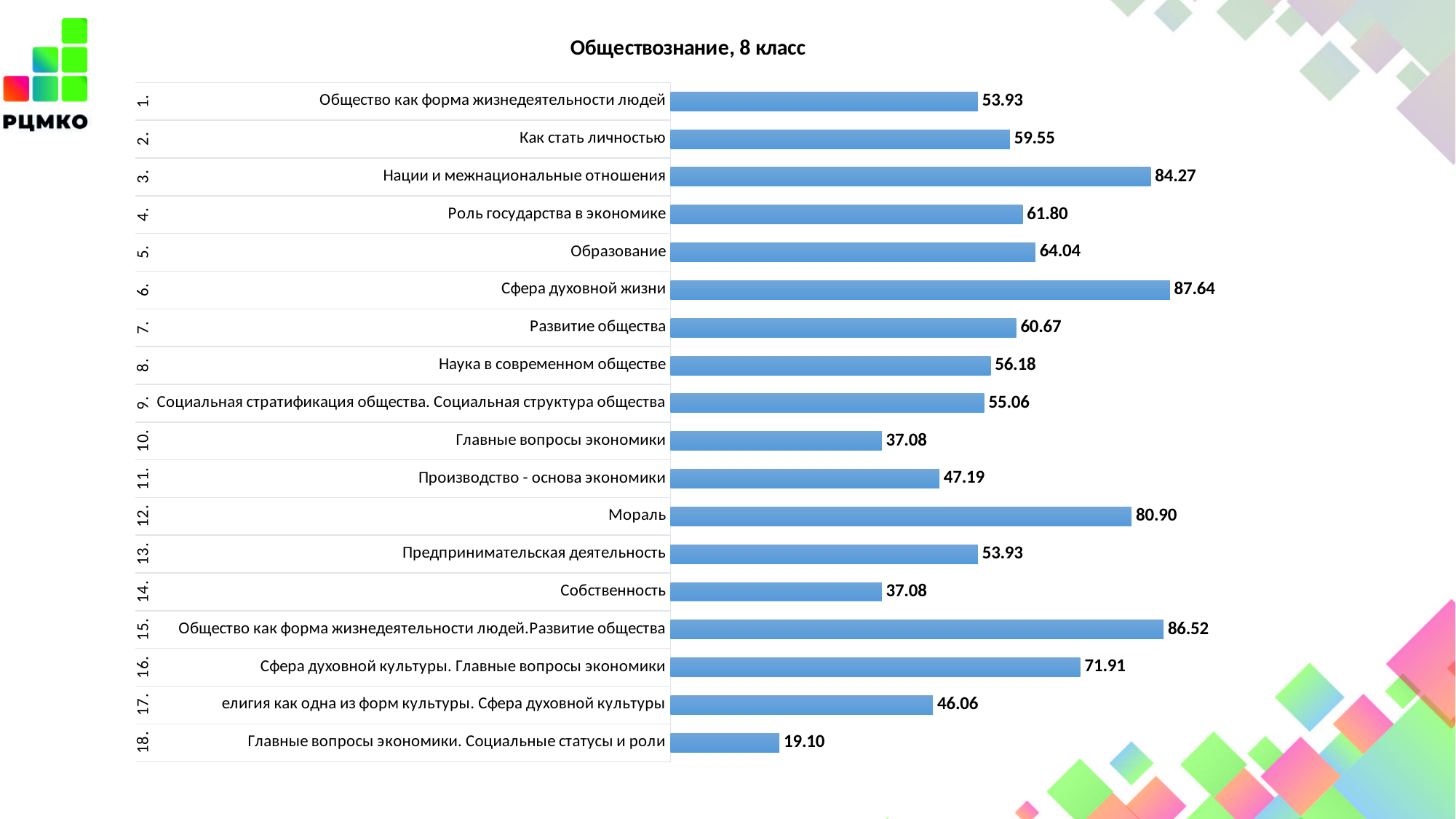
What is the difference between the values for "Мораль" and "Образование"? 16.86 What type of chart is shown on the slide? Bar chart What is the value for "Сфера духовной жизни"? 87.64 What is the value for "Производство - основа экономики"? 47.19 What is the title of the chart? Обществознание, 8 класс How many categories (topics) are plotted in the chart? 18 Which has a larger value: "Нации и межнациональные отношения" or "Мораль"? Нации и межнациональные отношения What is the difference between the highest value (Сфера духовной жизни) and the lowest value (Главные вопросы экономики. Социальные статусы и роли)? 68.54 Which topic has the lowest value? Главные вопросы экономики. Социальные статусы и роли Which topic has the highest value? Сфера духовной жизни What is the value for "Образование"? 64.04 What is the value for "Мораль"? 80.90